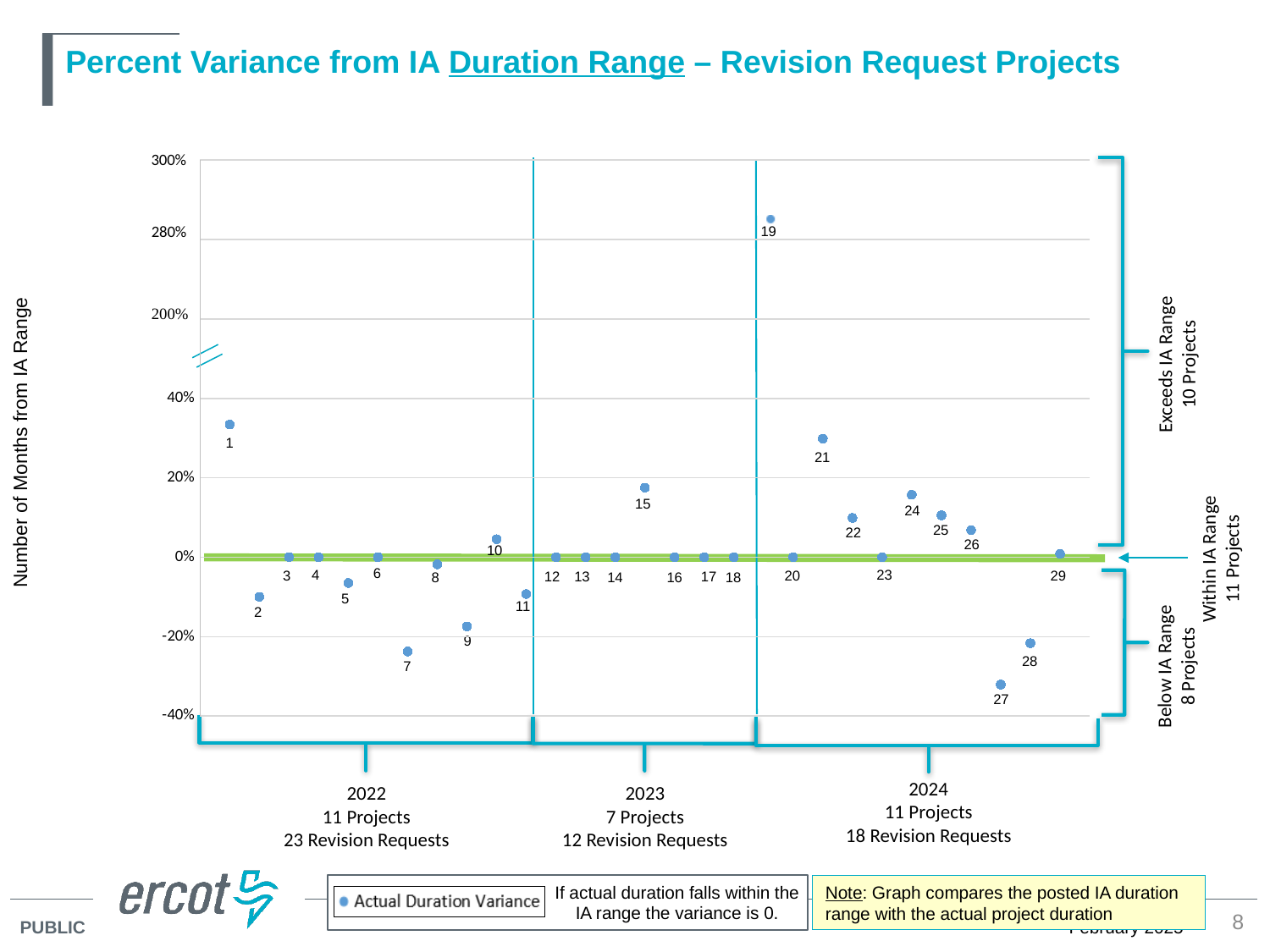
What is the percent variance value for project 20? 0% What kind of chart is shown on the slide? scatter chart Is the value for project 1 greater or less than 20%? greater How many series does the legend list? 1 Is the value for project 19 greater or less than 200%? greater Which project number has the lowest percent variance from the IA range? 27 Is the value for project 7 greater or less than -20%? less What is the name of the series shown in the legend? Actual Duration Variance How many project points are plotted on the chart? 29 Which has the larger percent variance, project 1 or project 21? project 1 Which project number has the highest percent variance from the IA range? 19